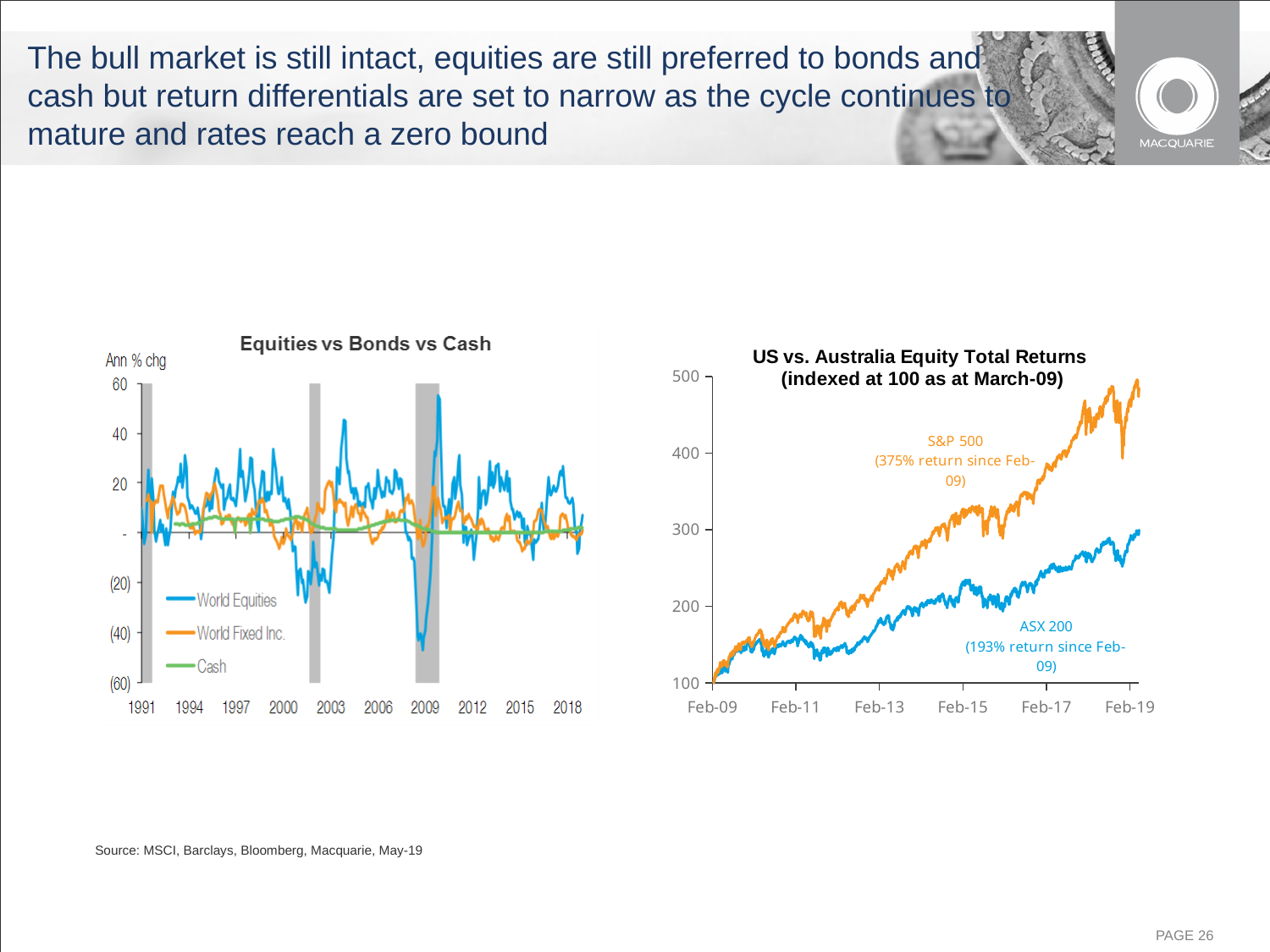
In the 'US vs. Australia Equity Total Returns' chart, is the ASX 200 value at Feb-19 greater or less than 400? less In the 'Equities vs Bonds vs Cash' chart, which series is shown in green? Cash In the 'US vs. Australia Equity Total Returns' chart, which series has the higher return since Feb-09, S&P 500 or ASX 200? S&P 500 What type of chart is the 'Equities vs Bonds vs Cash' chart on the left? line chart In the 'Equities vs Bonds vs Cash' chart, is the lowest value of World Equities around 2009 greater or less than (40)? less How many series does the legend of the 'Equities vs Bonds vs Cash' chart list? 3 What type of chart is the 'US vs. Australia Equity Total Returns' chart on the right? line chart In the 'US vs. Australia Equity Total Returns' chart, what return since Feb-09 is stated for the S&P 500? 375% How many series are plotted in the 'US vs. Australia Equity Total Returns' chart? 2 In the 'US vs. Australia Equity Total Returns' chart, do the S&P 500 values generally rise or fall from Feb-09 to Feb-19? rise In the 'Equities vs Bonds vs Cash' chart, what is the label on the y axis? Ann % chg In the 'US vs. Australia Equity Total Returns' chart, what return since Feb-09 is stated for the ASX 200? 193%